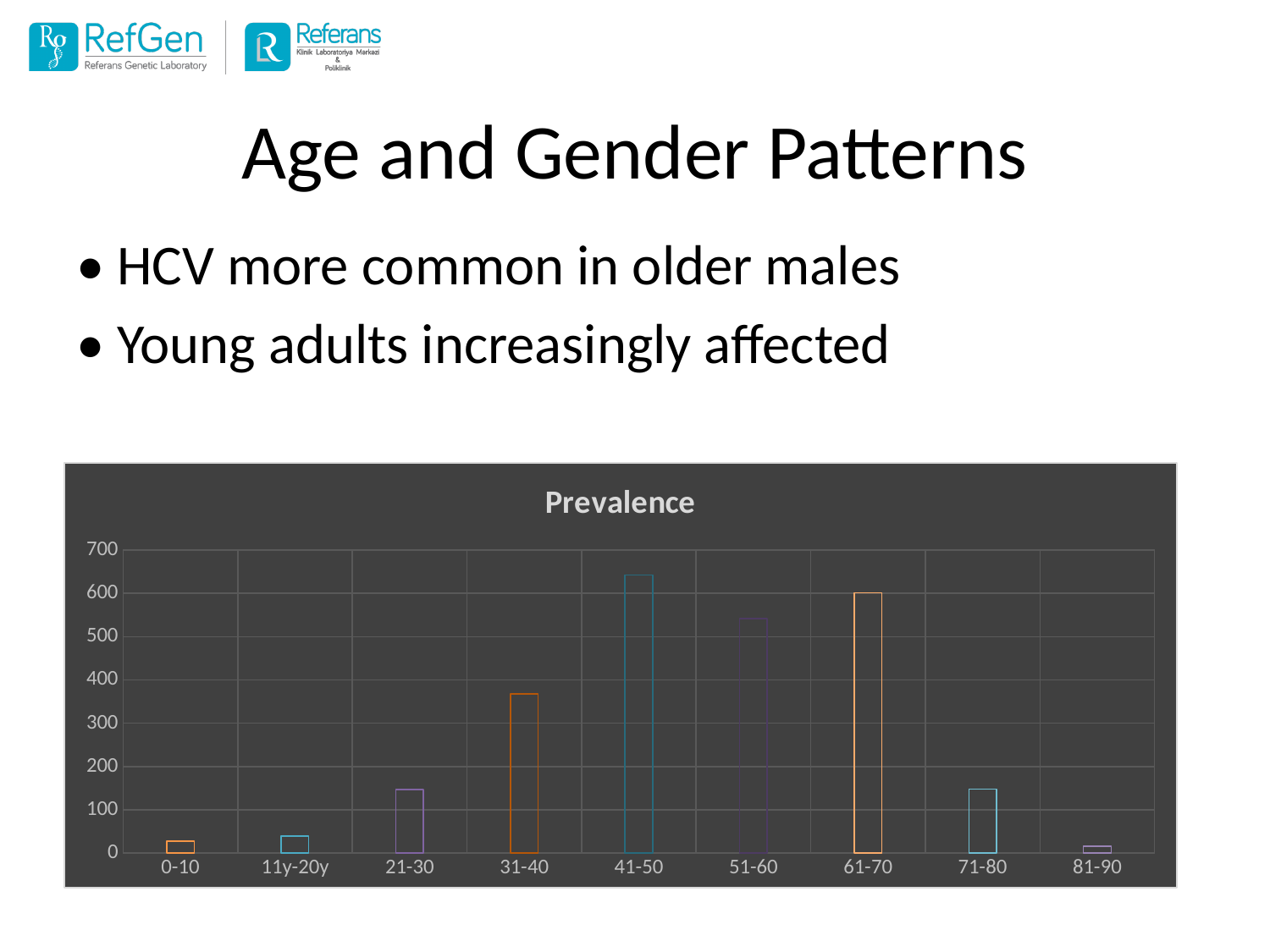
Is the value for 0-10 greater or less than 100? less What is the title of the chart? Prevalence Is the value for 51-60 greater or less than 500? greater Do the values rise or fall from the 61-70 category to the 81-90 category? fall Is the value for 41-50 greater or less than 600? greater Do the values rise or fall from the 0-10 category to the 41-50 category? rise How many age categories are shown on the x axis of the chart? 9 Which has the larger value, 31-40 or 51-60? 51-60 What kind of chart is shown on the slide? bar chart Which age category has the highest value in the chart? 41-50